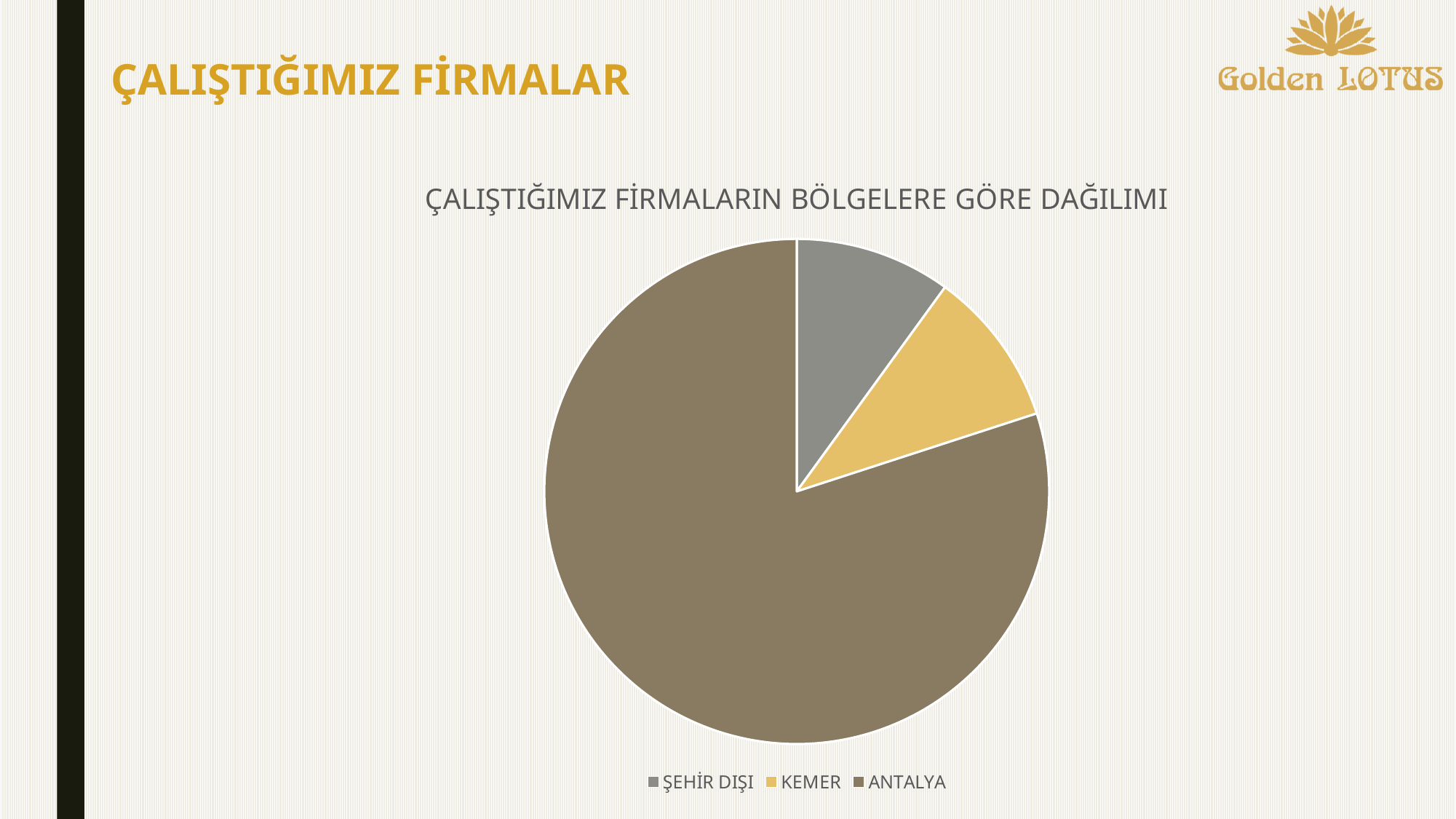
How many slices does the pie chart have? 3 What is the title of the pie chart? ÇALIŞTIĞIMIZ FİRMALARIN BÖLGELERE GÖRE DAĞILIMI What kind of chart is shown on the slide? pie chart Which slice is larger, ANTALYA or ŞEHİR DIŞI? ANTALYA How many entries does the legend of the pie chart list? 3 Which region is shown in yellow in the pie chart? KEMER Which region has the largest slice in the pie chart? ANTALYA Which slice is larger, ANTALYA or KEMER? ANTALYA